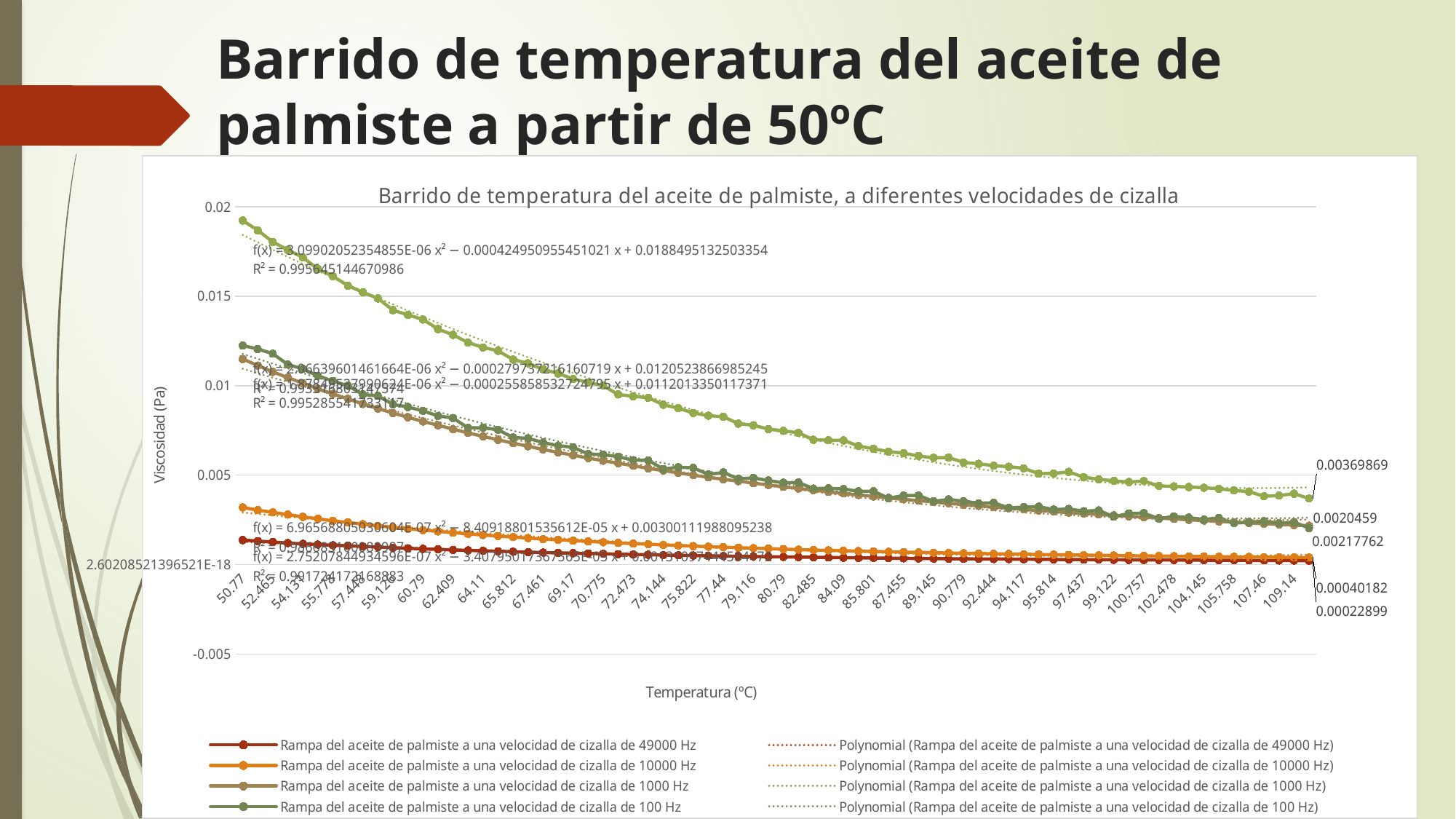
At 50.77, which is larger: the value for the 100 Hz series or the value for the 49000 Hz series? 100 Hz What is the title of the chart? Barrido de temperatura del aceite de palmiste, a diferentes velocidades de cizalla What is the highest tick value shown on the vertical axis? 0.02 Among the series listed in the legend, which has the lowest viscosity values across the temperature range? Rampa del aceite de palmiste a una velocidad de cizalla de 49000 Hz Is the value for 'Rampa del aceite de palmiste a una velocidad de cizalla de 10000 Hz' at 50.77 greater or less than 0.005? less At 50.77, which is larger: the value for the 10000 Hz series or the value for the 49000 Hz series? 10000 Hz What is the label of the vertical axis of the chart? Viscosidad (Pa) Is the value for 'Rampa del aceite de palmiste a una velocidad de cizalla de 49000 Hz' at 50.77 greater or less than 0.005? less What kind of chart is shown on the slide? line chart Is the value for 'Rampa del aceite de palmiste a una velocidad de cizalla de 100 Hz' at 50.77 greater or less than 0.01? greater How many entries does the chart legend list? 8 As temperature increases along the x axis, do the viscosity values rise or fall? fall